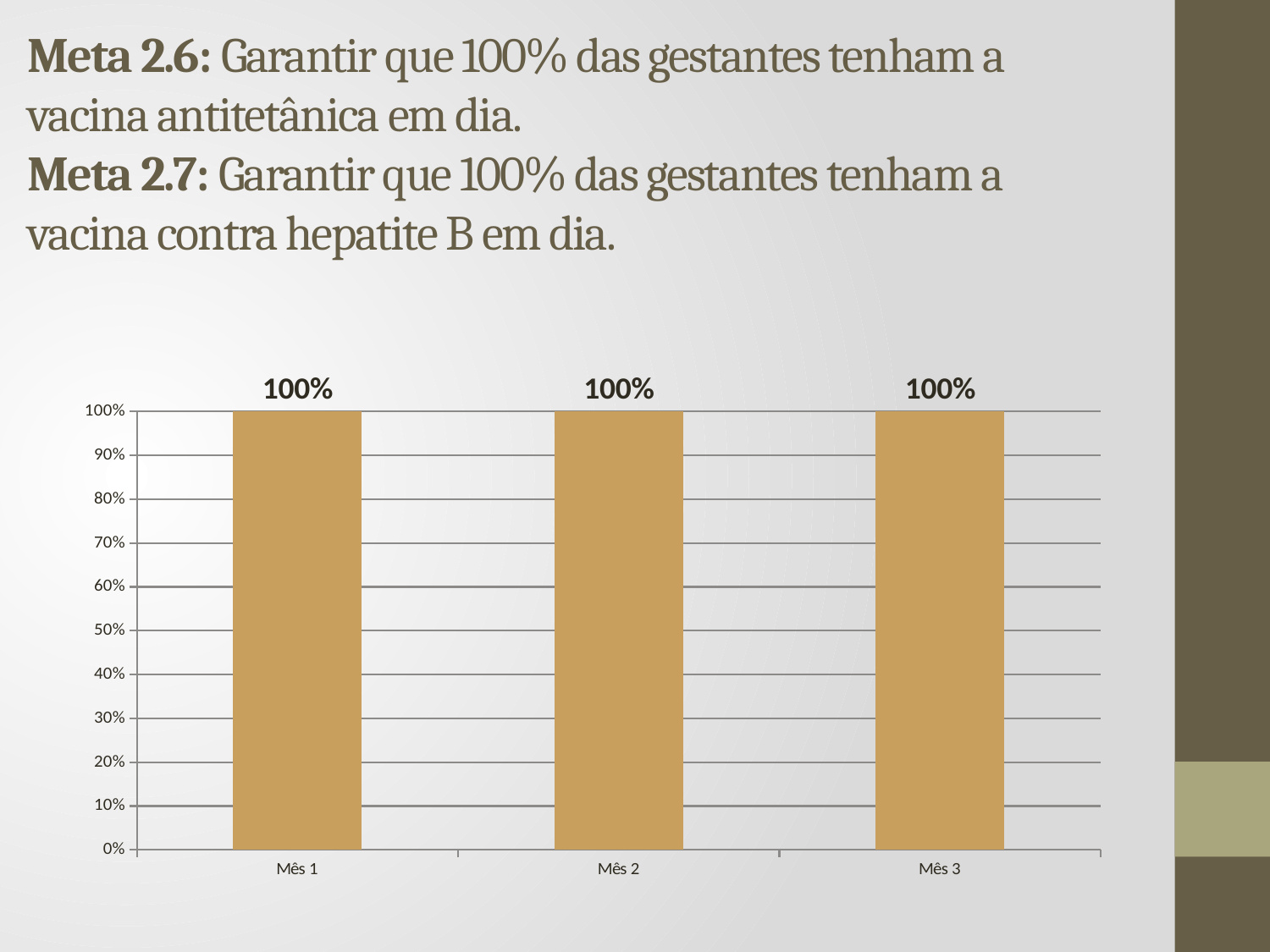
Is the value for Mês 2 greater or less than 90%? greater What kind of chart is shown on the slide? bar chart What is the value for Mês 1? 100% What is the highest value shown on the vertical axis of the chart? 100% Do the values rise, fall or stay the same from Mês 1 to Mês 3? stay the same What is the label of the first category on the x axis? Mês 1 What is the value for Mês 2? 100% How many categories are shown on the x axis of the chart? 3 What is the value for Mês 3? 100% What is the difference between the values for Mês 1 and Mês 3? 0%